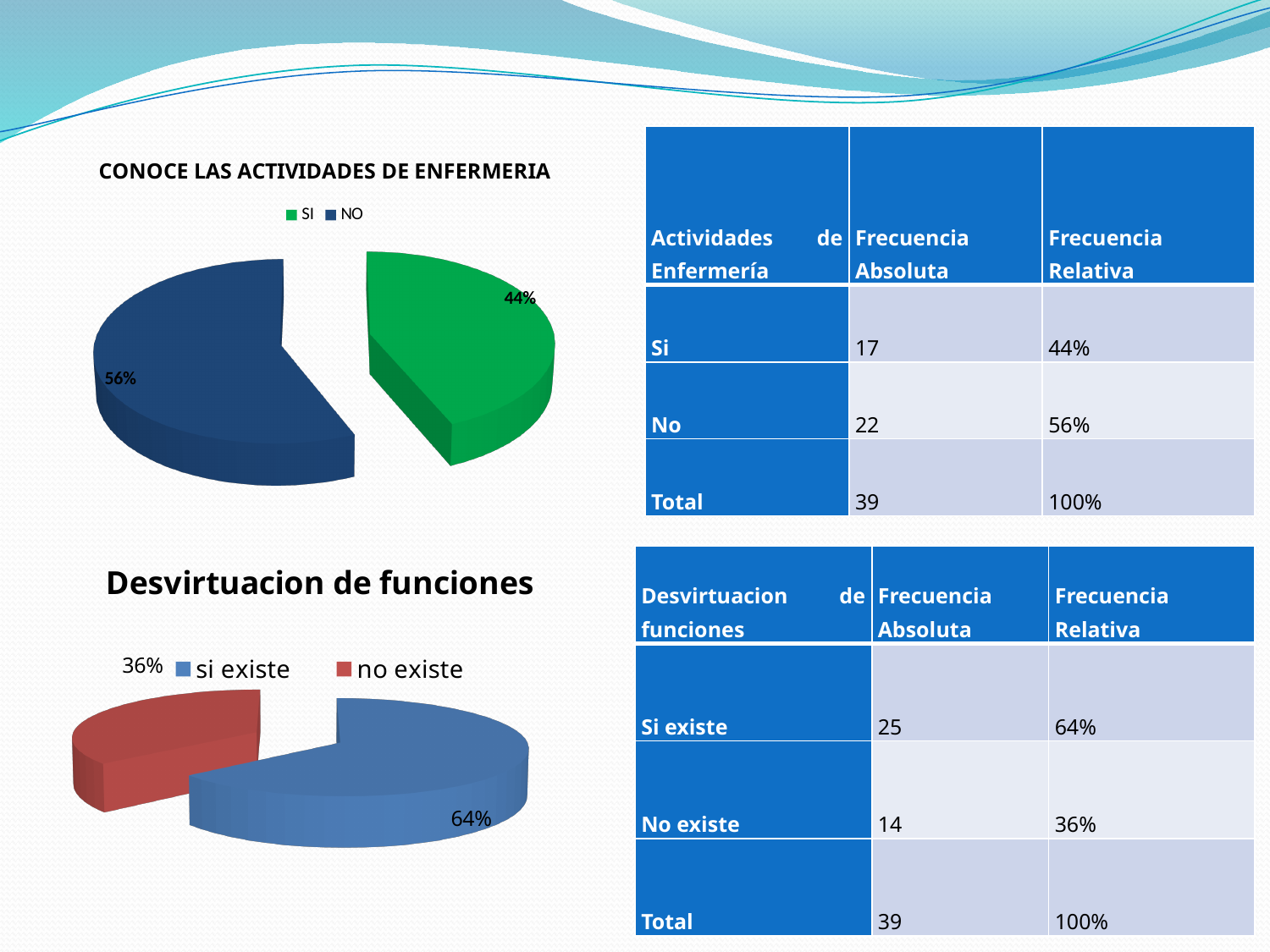
How many entries does the legend of the 'CONOCE LAS ACTIVIDADES DE ENFERMERIA' chart list? 2 In the 'Desvirtuacion de funciones' chart, what colour is the 'no existe' slice? Red In the 'Desvirtuacion de funciones' chart, is the 'si existe' slice larger or smaller than the 'no existe' slice? Larger What kind of chart is 'CONOCE LAS ACTIVIDADES DE ENFERMERIA'? Pie chart In the 'Desvirtuacion de funciones' chart, which slice is the smallest? no existe In the 'CONOCE LAS ACTIVIDADES DE ENFERMERIA' chart, which slice is the largest? NO In the 'CONOCE LAS ACTIVIDADES DE ENFERMERIA' chart, what share of the pie is labelled NO? 56% In the 'Desvirtuacion de funciones' chart, what share of the pie is labelled 'si existe'? 64% In the 'CONOCE LAS ACTIVIDADES DE ENFERMERIA' chart, what share of the pie is labelled SI? 44% In the 'CONOCE LAS ACTIVIDADES DE ENFERMERIA' chart, what is the difference in percentage points between the NO and SI slices? 12 In the 'Desvirtuacion de funciones' chart, what is the difference in percentage points between 'si existe' and 'no existe'? 28